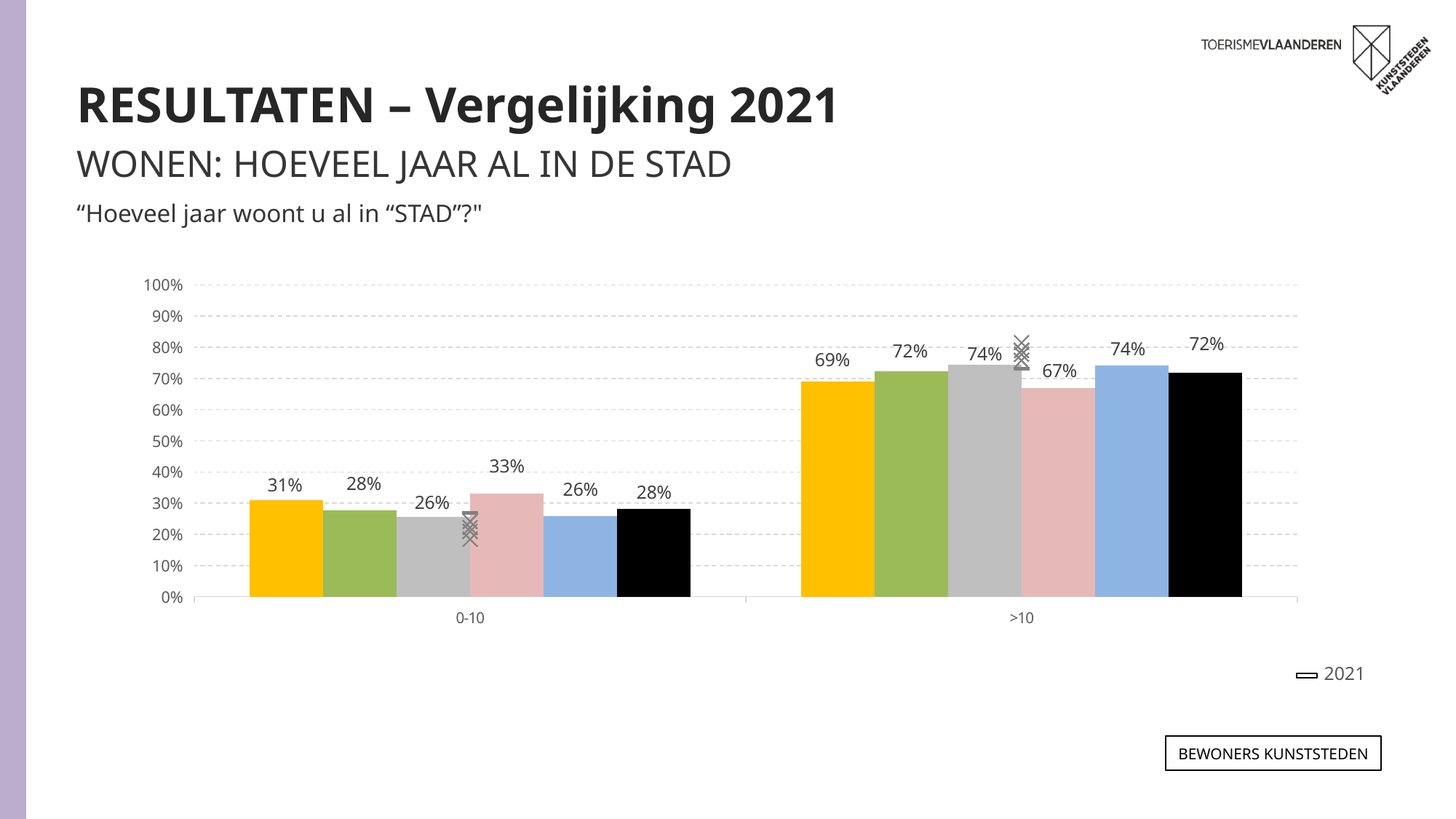
How many categories are shown on the x axis of the chart? 2 What is the highest value shown in the 0-10 category? 33% What is the value of the black bar for the 0-10 category? 28% What kind of chart is shown on the slide? bar chart Is the value of the grey bar for the >10 category greater or less than 60%? greater What are the two category labels on the x axis? 0-10 and >10 What is the value of the pink bar for the >10 category? 67% What is the value of the yellow bar for the 0-10 category? 31% What is the difference between the yellow bar's value for >10 and its value for 0-10? 38 percentage points What entry is shown in the chart legend? 2021 For the black bar, which category has the larger value, 0-10 or >10? >10 What is the lowest value shown in the >10 category? 67%